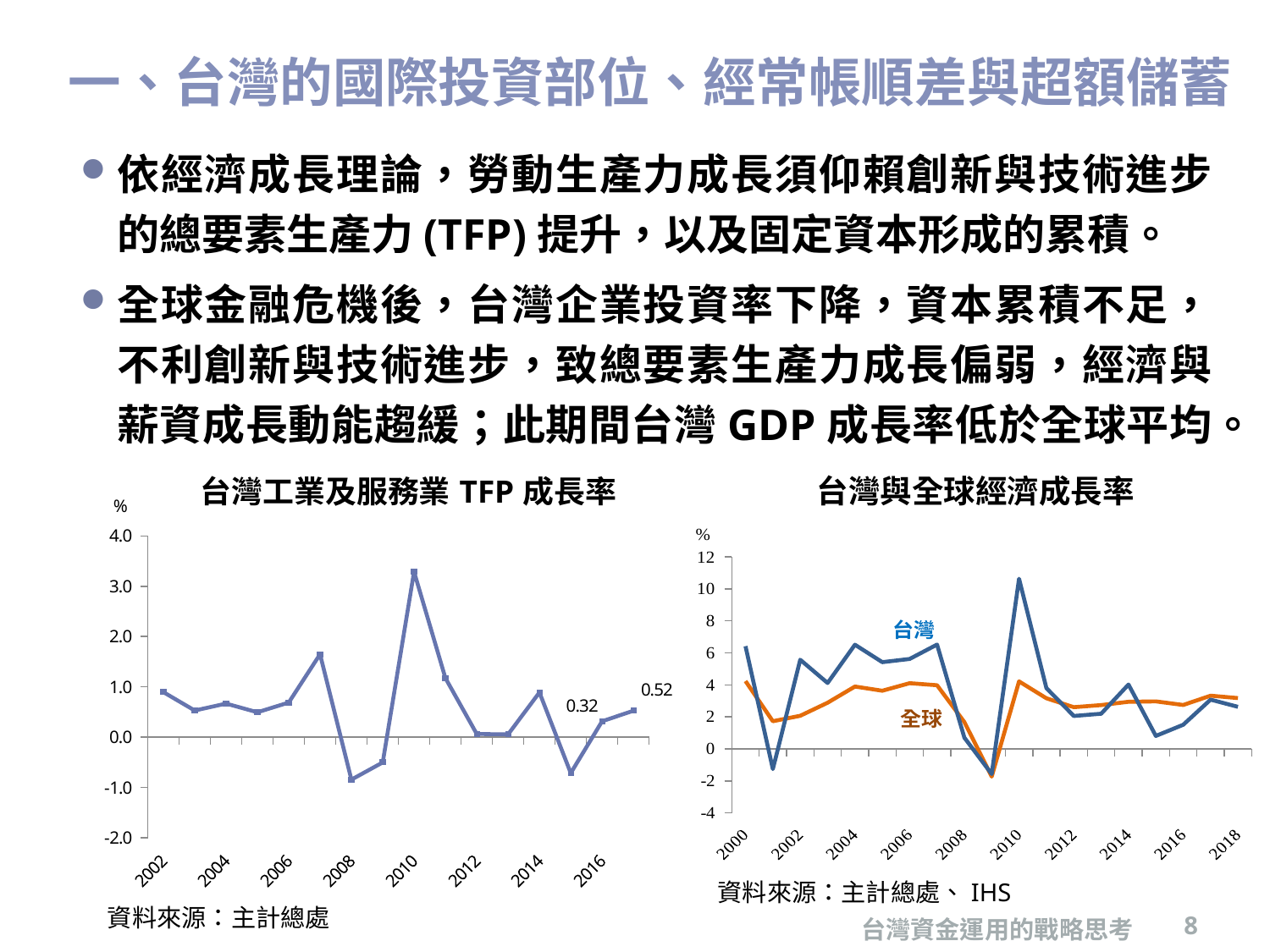
In the left chart (台灣工業及服務業 TFP 成長率), is the value for 2010 greater or less than 3.0? greater In the left chart (台灣工業及服務業 TFP 成長率), what is the labeled value for 2016? 0.32 In the left chart (台灣工業及服務業 TFP 成長率), what is the difference between the two labeled values 0.52 and 0.32? 0.20 In the left chart (台灣工業及服務業 TFP 成長率), what is the labeled value of the last data point? 0.52 In the right chart (台灣與全球經濟成長率), what are the names of the two series? 台灣 and 全球 In the right chart (台灣與全球經濟成長率), in 2001, which series has the larger value, 台灣 or 全球? 全球 In the left chart (台灣工業及服務業 TFP 成長率), which year has the lowest TFP growth rate? 2008 What kind of chart is the left chart titled 台灣工業及服務業 TFP 成長率? line chart In the right chart (台灣與全球經濟成長率), in which year does the 台灣 series reach its highest value? 2010 In the right chart (台灣與全球經濟成長率), how many series are plotted? 2 In the left chart (台灣工業及服務業 TFP 成長率), which year has the highest TFP growth rate? 2010 In the right chart (台灣與全球經濟成長率), is the 台灣 value for 2010 greater or less than 10? greater